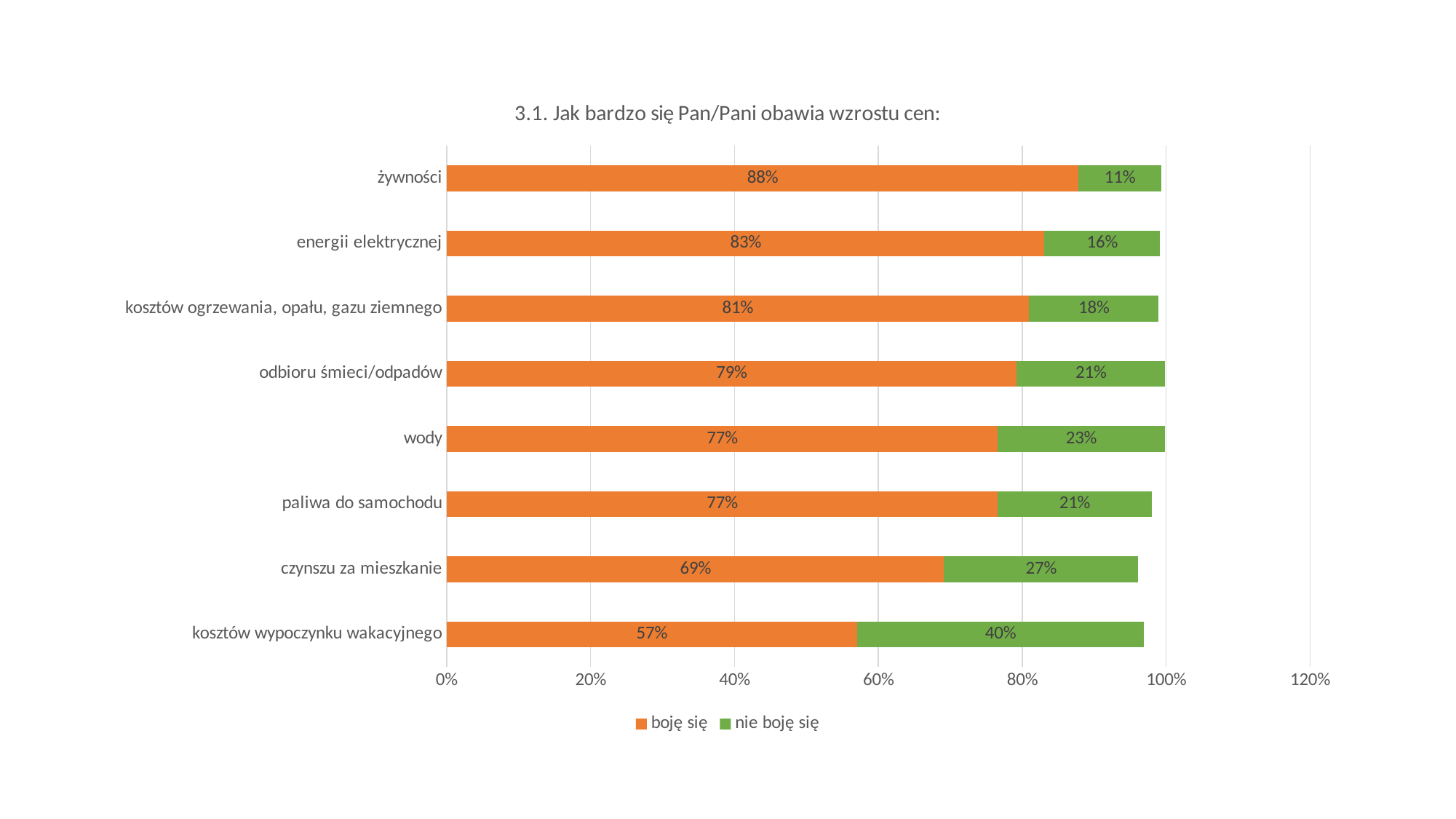
What is the difference between the "boję się" values for energii elektrycznej and wody? 6% What is the "nie boję się" value for kosztów wypoczynku wakacyjnego? 40% Which category has the highest "boję się" value? żywności What percentage of respondents said "boję się" about the price of żywności? 88% How many categories are shown on the chart? 8 What is the "boję się" value for czynszu za mieszkanie? 69% What kind of chart is shown on the slide? stacked bar chart Which is larger: the "nie boję się" value for czynszu za mieszkanie or for paliwa do samochodu? czynszu za mieszkanie Which category has the lowest "boję się" value? kosztów wypoczynku wakacyjnego What is the total of the stacked bar for odbioru śmieci/odpadów? 100% How many series does the legend list? 2 What colour represents the "nie boję się" series? green